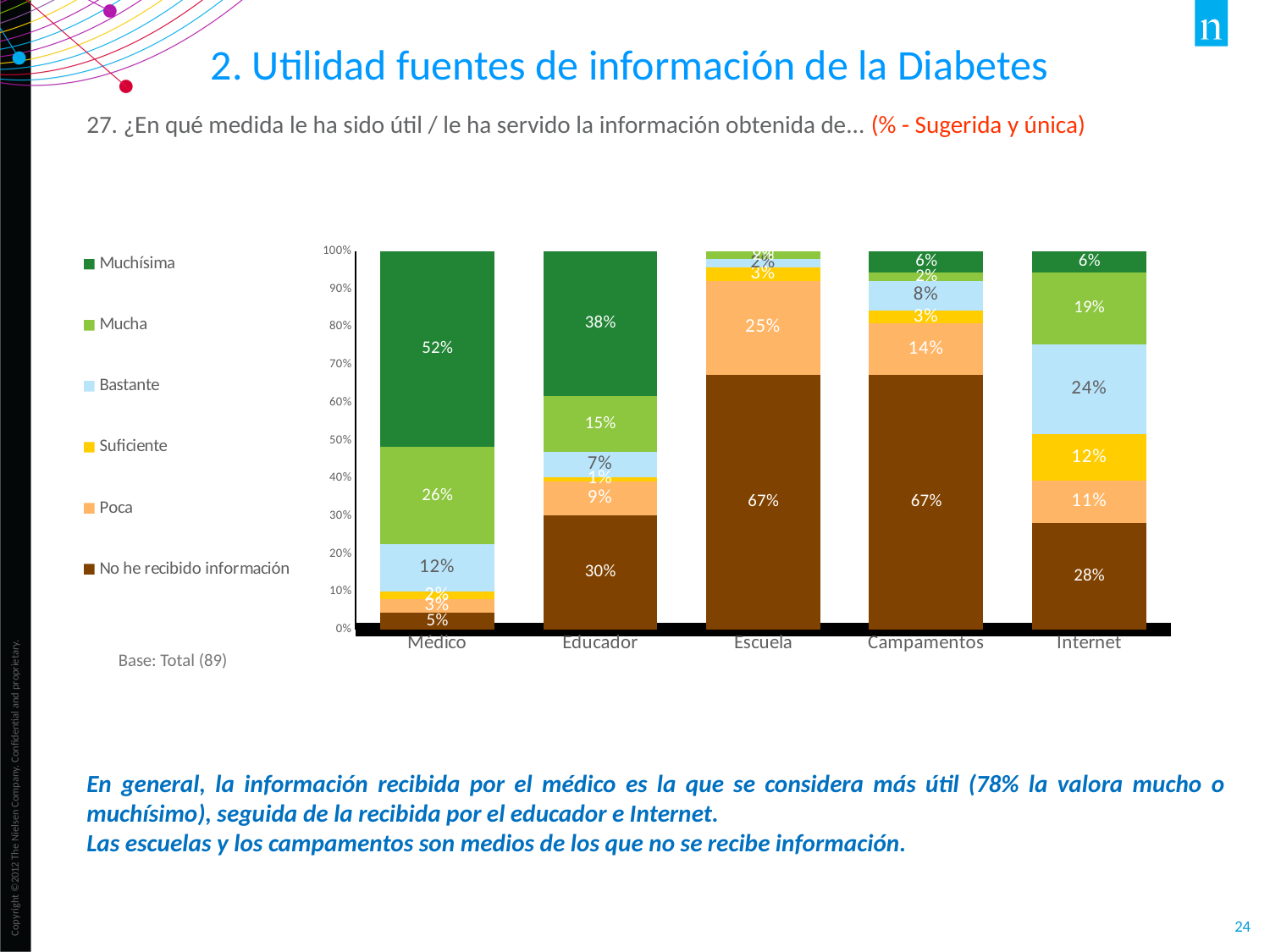
What is the value of 'Poca' for Campamentos? 14% What type of chart is shown on the slide? stacked bar chart Which is larger, the 'Mucha' value for Internet or the 'Mucha' value for Educador? Internet What is the value of 'No he recibido información' for Escuela? 67% Which category has the lowest value for 'No he recibido información'? Médico What is the value of 'Bastante' for Internet? 24% How many series does the legend list? 6 What is the base (sample size) stated below the chart? Total (89) What is the value of 'Muchísima' for Médico? 52% How many categories are shown on the x axis? 5 What is the difference between the 'Muchísima' values for Médico and Educador? 14% Which category has the highest value for 'Muchísima'? Médico